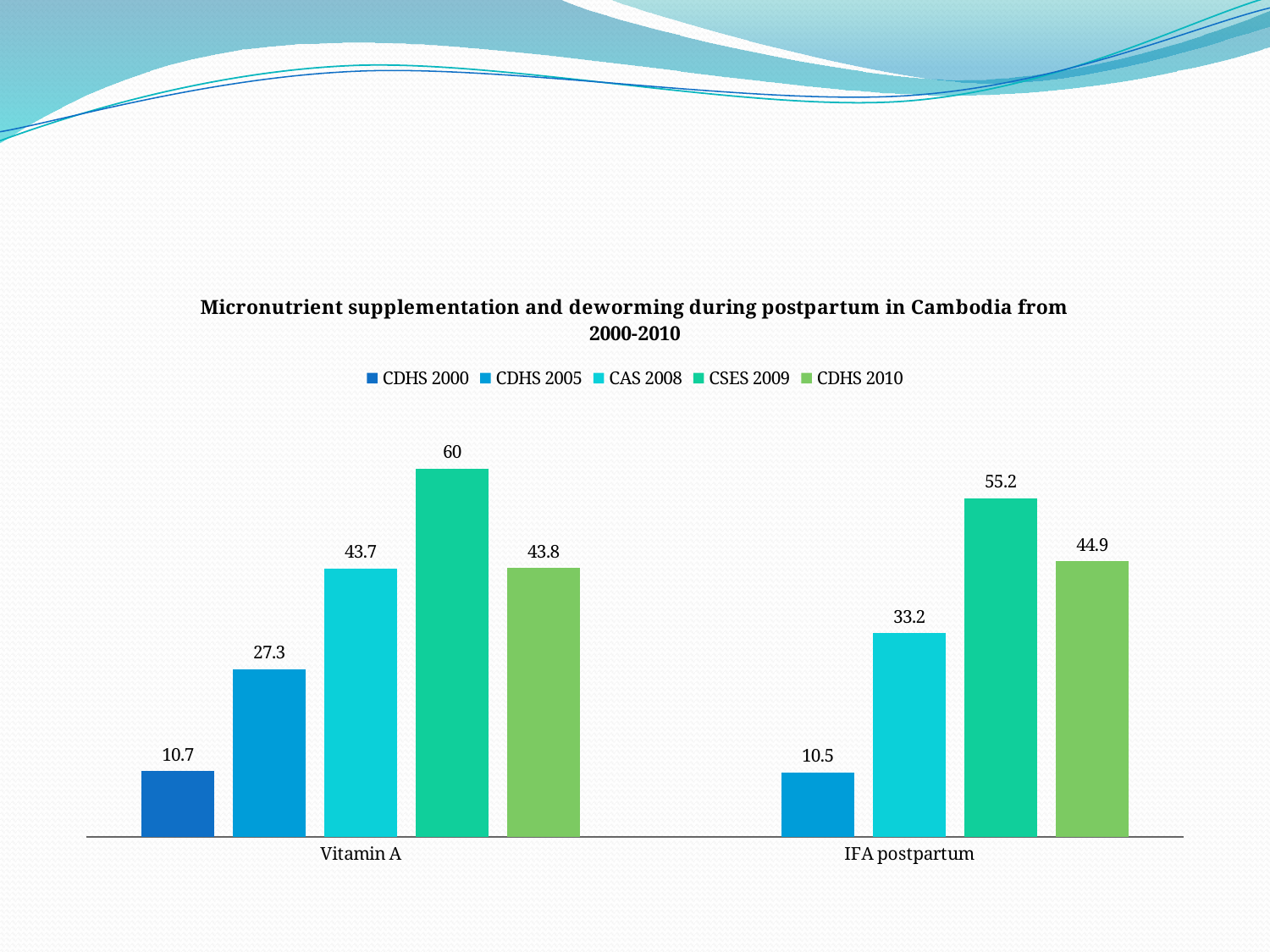
What is the value for CAS 2008 in the IFA postpartum category? 33.2 Which is larger: the CDHS 2005 value for Vitamin A or the CAS 2008 value for IFA postpartum? CAS 2008 value for IFA postpartum What is the difference between the CSES 2009 and CDHS 2010 values in the IFA postpartum category? 10.3 Which series has the highest value in the IFA postpartum category? CSES 2009 How many series does the legend list? 5 What is the value for CDHS 2010 in the IFA postpartum category? 44.9 Which series has the lowest value in the Vitamin A category? CDHS 2000 What is the difference between the CSES 2009 and CDHS 2005 values in the Vitamin A category? 32.7 What kind of chart is shown on the slide? Bar chart What is the title of the chart? Micronutrient supplementation and deworming during postpartum in Cambodia from 2000-2010 What is the value for CSES 2009 in the Vitamin A category? 60 What is the value for CDHS 2000 in the Vitamin A category? 10.7